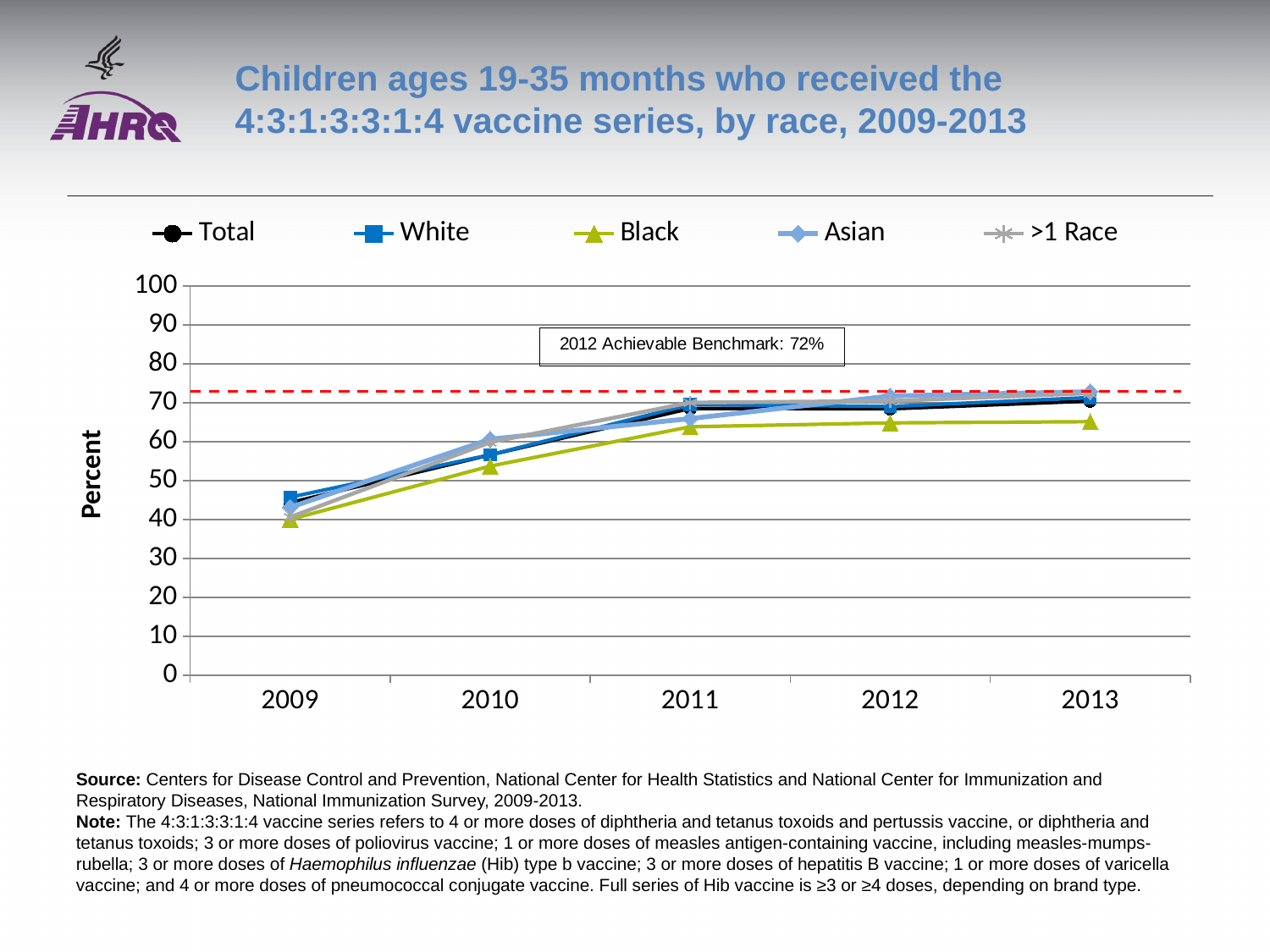
How many series does the legend list? 5 What is the 2012 Achievable Benchmark shown on the chart? 72% Is the value for Black in 2013 greater or less than 60? greater How many years are shown on the x axis? 5 Does the value for Black rise or fall from 2009 to 2013? rise Is the value for Total in 2011 greater or less than 60? greater Which series is plotted with a green line and triangle markers? Black In 2010, which is larger, the value for White or the value for Black? White What kind of chart is shown on the slide? line chart Is the value for Black in 2009 greater or less than 50? less Which series has the lowest value in 2013? Black Which series has the lowest value in 2012? Black